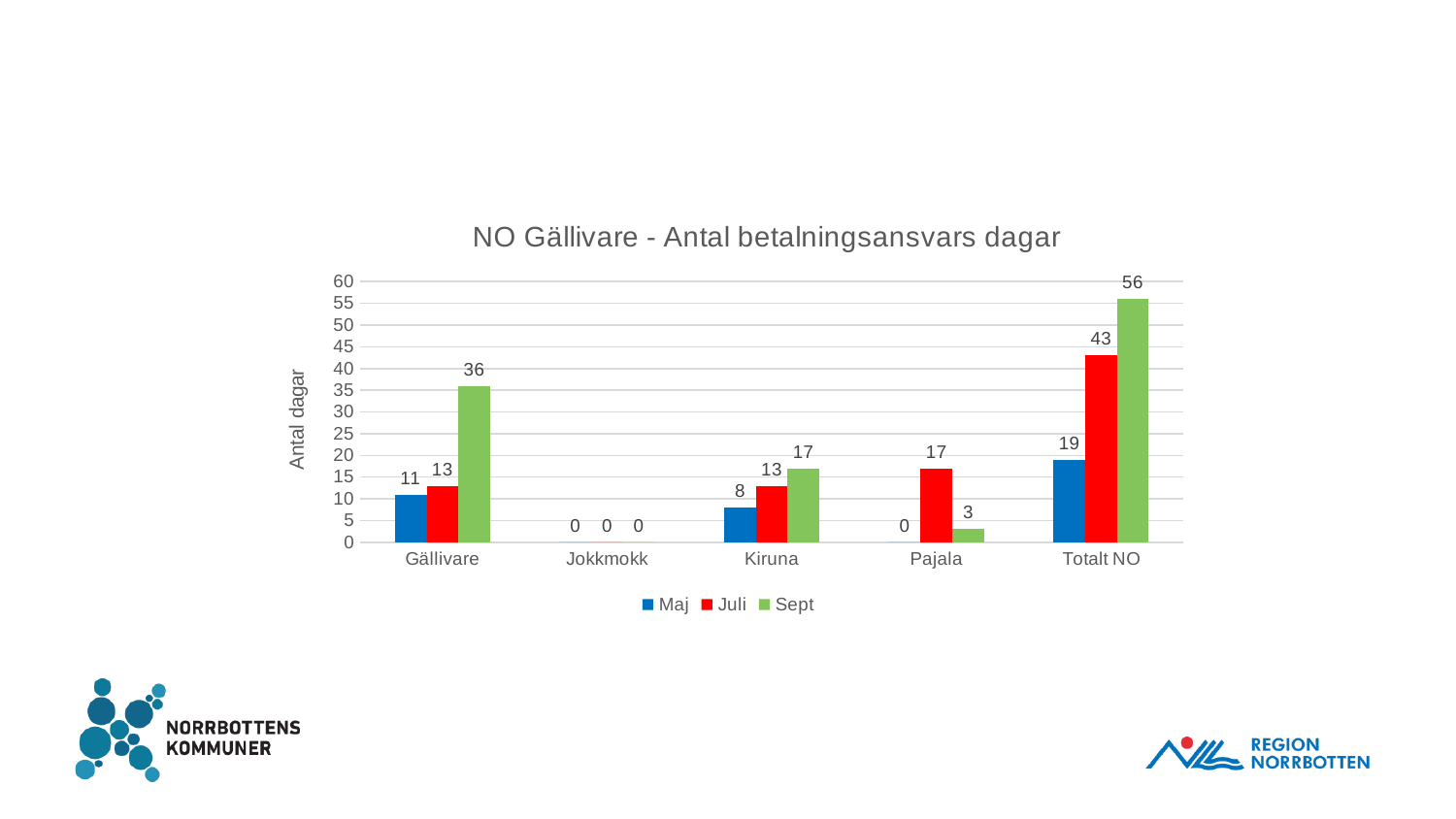
What is the Sept value for Gällivare? 36 What is the Sept value for Totalt NO? 56 How many categories are shown on the x axis? 5 What is the Maj value for Kiruna? 8 How many series does the legend list? 3 What is the difference between the Sept and Maj values for Totalt NO? 37 Which category has the highest Juli value? Totalt NO Excluding Totalt NO, which category has the lowest Sept value? Jokkmokk What kind of chart is shown on the slide? Bar chart Which is larger for Kiruna, the Juli value or the Sept value? Sept What is the Juli value for Pajala? 17 What is the title of the chart? NO Gällivare - Antal betalningsansvars dagar